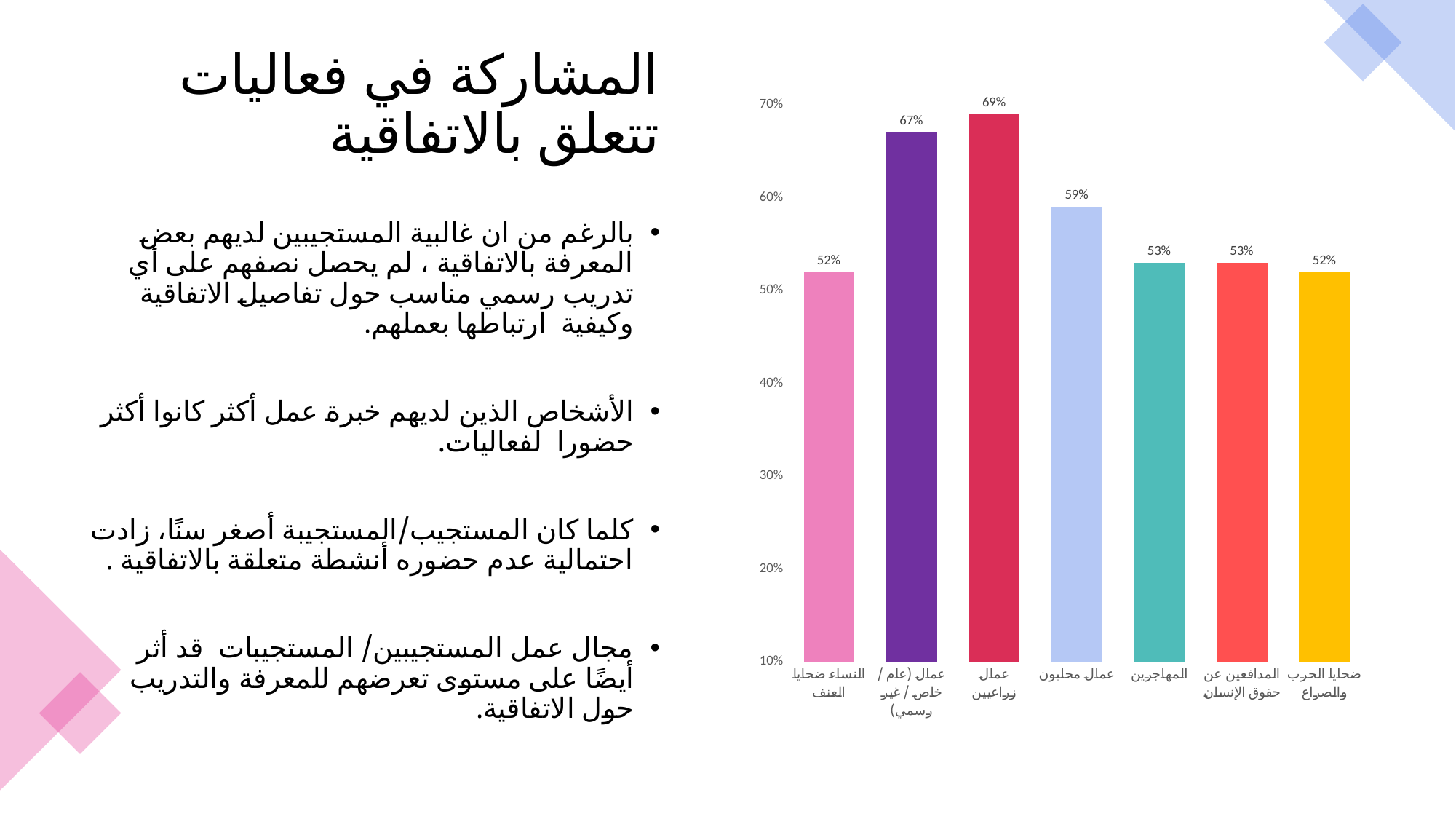
How many categories are shown in the bar chart? 7 Is the value for ضحايا الحرب والصراع greater or less than 60%? less What type of chart is shown on the slide? bar chart What is the value for عمال زراعيين? 69% What is the difference between the values for عمال (عام / خاص / غير رسمي) and النساء ضحايا العنف? 15% What is the value for المهاجرين? 53% What is the value for النساء ضحايا العنف? 52% What is the value for عمال محليون? 59% What is the value for عمال (عام / خاص / غير رسمي)? 67% Which is larger, the value for عمال (عام / خاص / غير رسمي) or the value for المدافعين عن حقوق الإنسان? عمال (عام / خاص / غير رسمي) What is the difference between the values for عمال زراعيين and عمال محليون? 10% Which category has the highest value? عمال زراعيين